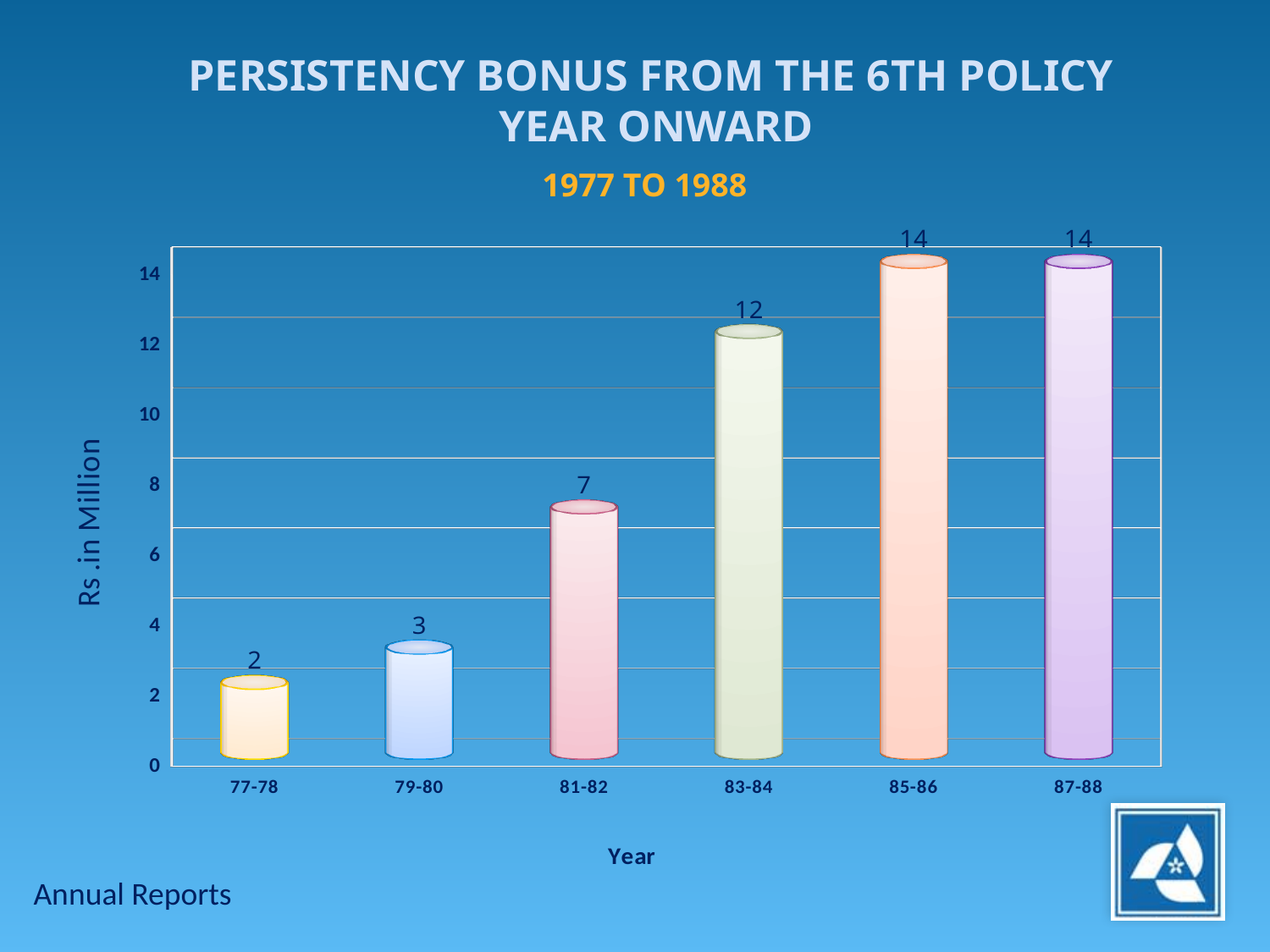
Do the values generally rise or fall from 77-78 to 87-88? Rise What is the persistency bonus value for 77-78? 2 What kind of chart is shown on the slide? Bar chart What is the difference between the values for 85-86 and 81-82? 7 Is the value for 83-84 greater or less than 10? greater How many years are shown on the x axis? 6 What is the persistency bonus value for 81-82? 7 Which is larger, the value for 79-80 or the value for 81-82? 81-82 Which year has the lowest persistency bonus? 77-78 What is the label of the y axis? Rs .in Million What is the persistency bonus value for 83-84? 12 What is the difference between the values for 83-84 and 79-80? 9